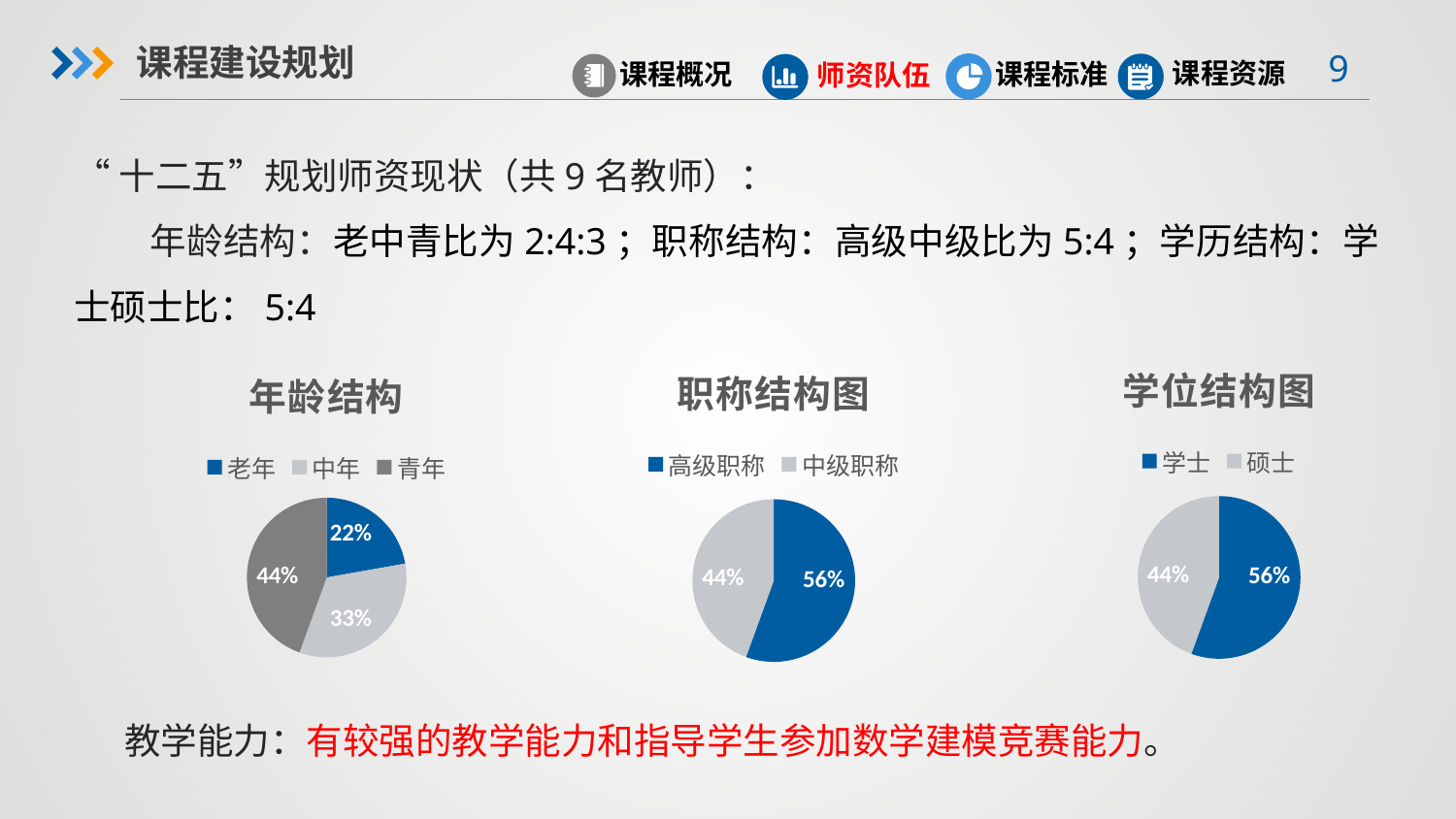
In the 年龄结构 chart, how many slices does the pie have? 3 In the 年龄结构 chart, which category has the smallest slice? 老年 In the 学位结构图 chart, what is the difference between the 学士 and 硕士 shares? 12% In the 职称结构图 chart, what percentage is shown for 中级职称? 44% How many entries does the legend of the 学位结构图 chart list? 2 In the 职称结构图 chart, what percentage is shown for 高级职称? 56% What type of chart is the 职称结构图 chart? pie chart In the 学位结构图 chart, what percentage is shown for 硕士? 44% In the 职称结构图 chart, which category has the larger share, 高级职称 or 中级职称? 高级职称 In the 年龄结构 chart, what is the difference between the largest slice (44%) and the smallest slice (22%)? 22% In the 年龄结构 chart, what percentage is shown for 老年? 22% In the 学位结构图 chart, what percentage is shown for 学士? 56%